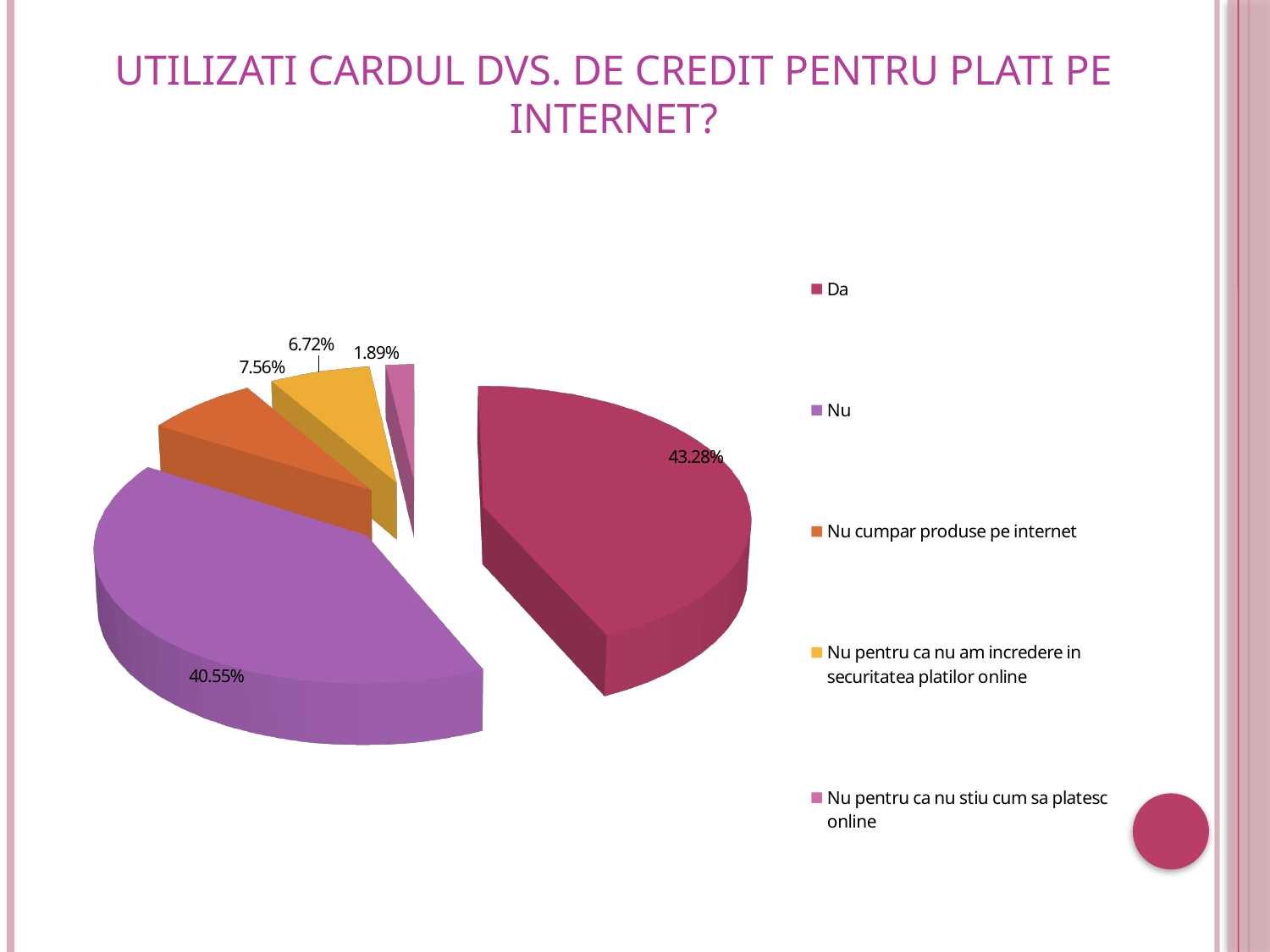
What percentage is labelled for "Nu pentru ca nu am incredere in securitatea platilor online"? 6.72% What is the title of the chart on the slide? UTILIZATI CARDUL DVS. DE CREDIT PENTRU PLATI PE INTERNET? What is the difference between the "Da" and "Nu" percentages? 2.73% What percentage is shown for the "Nu" slice? 40.55% What is the value for "Nu cumpar produse pe internet"? 7.56% What is the value for "Nu pentru ca nu stiu cum sa platesc online"? 1.89% Which is larger, "Nu cumpar produse pe internet" or "Nu pentru ca nu am incredere in securitatea platilor online"? Nu cumpar produse pe internet Which category has the smallest slice of the pie? Nu pentru ca nu stiu cum sa platesc online What type of chart is shown on the slide? Pie chart How many slices does the pie chart have? 5 Which category has the largest slice of the pie? Da What share of the pie does the "Da" slice represent? 43.28%